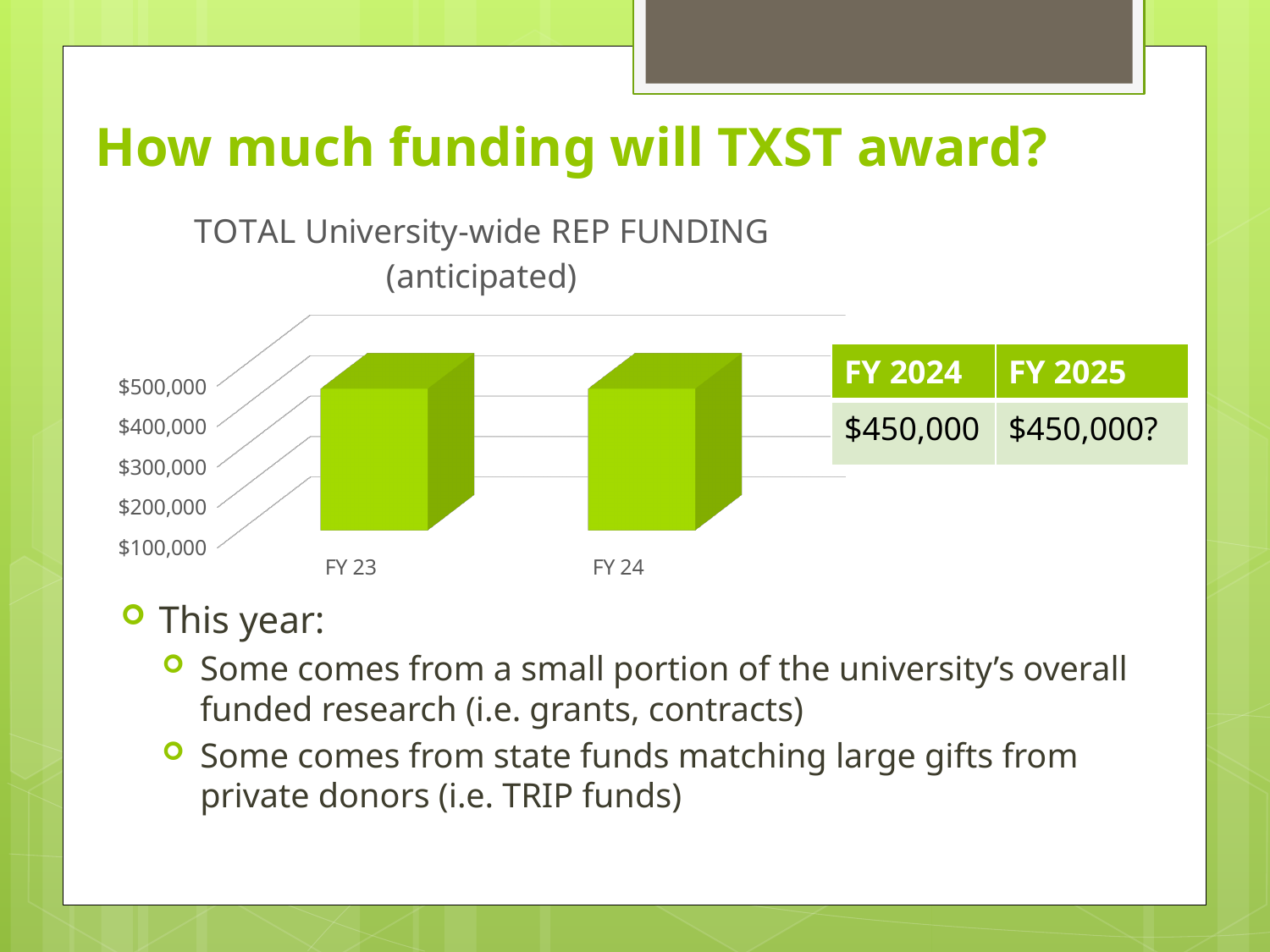
Is the value for FY 23 greater or less than $200,000? greater How many categories (bars) does the chart show? 2 Is the value for FY 23 greater or less than $300,000? greater Is the value for FY 24 greater or less than $300,000? greater What is the lowest tick label shown on the vertical axis of the chart? $100,000 What is the title of the chart? TOTAL University-wide REP FUNDING (anticipated) What are the category labels on the x axis of the chart? FY 23 and FY 24 What kind of chart is shown on the slide? bar chart